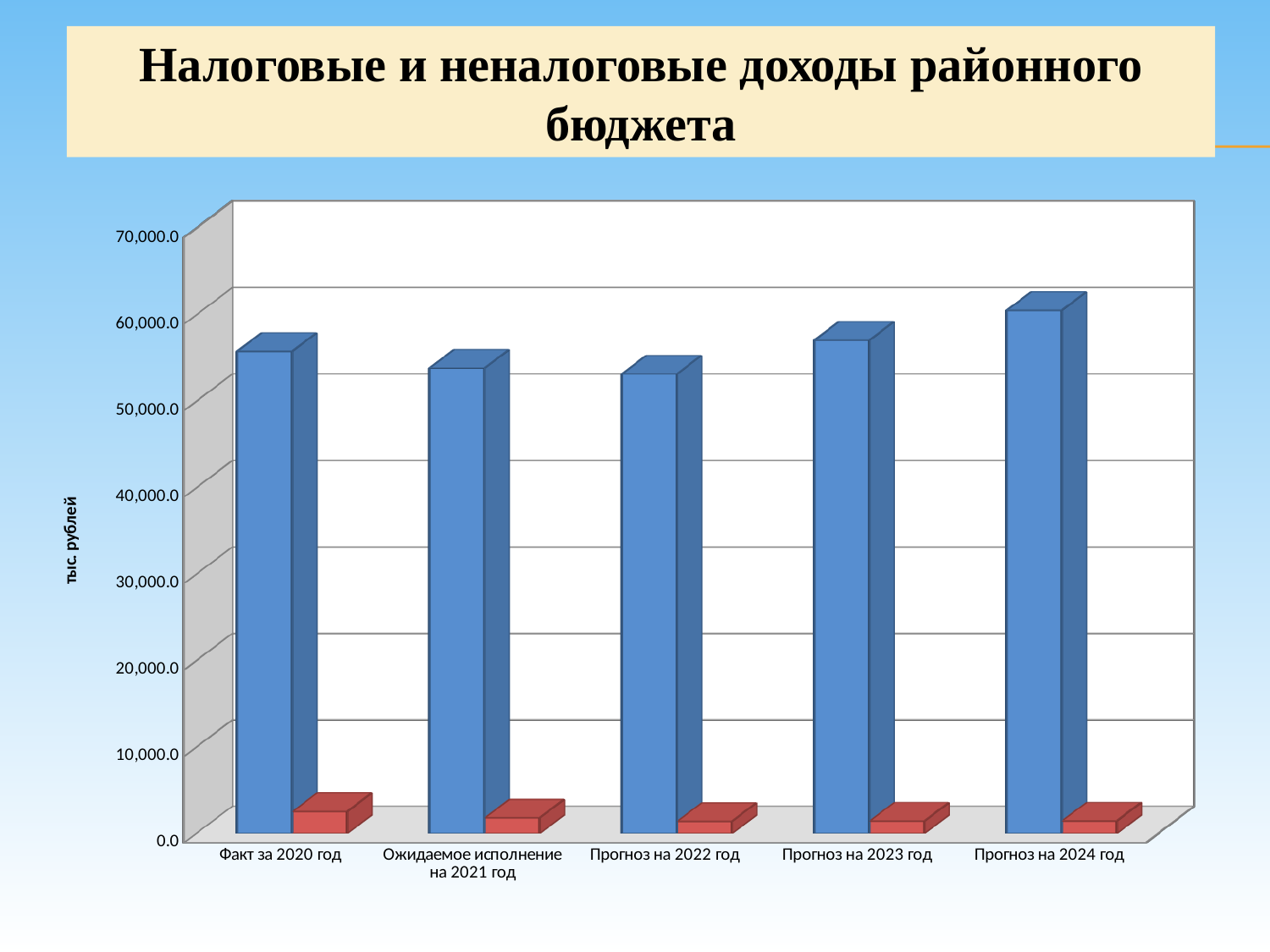
How many categories are shown along the x axis of the chart? 5 Is the blue bar for Прогноз на 2024 год greater or less than 50,000.0? greater What kind of chart is shown on the slide? bar chart Which blue bar is taller: Прогноз на 2023 год or Ожидаемое исполнение на 2021 год? Прогноз на 2023 год Is the blue bar for Факт за 2020 год greater or less than 40,000.0? greater What is the title of the slide containing the chart? Налоговые и неналоговые доходы районного бюджета Do the blue bars rise or fall from Прогноз на 2022 год to Прогноз на 2024 год? rise Is the blue bar for Прогноз на 2022 год greater or less than 60,000.0? less Which category has the tallest blue bar? Прогноз на 2024 год Which blue bar is taller: Прогноз на 2024 год or Факт за 2020 год? Прогноз на 2024 год What is the label on the vertical axis of the chart? тыс. рублей